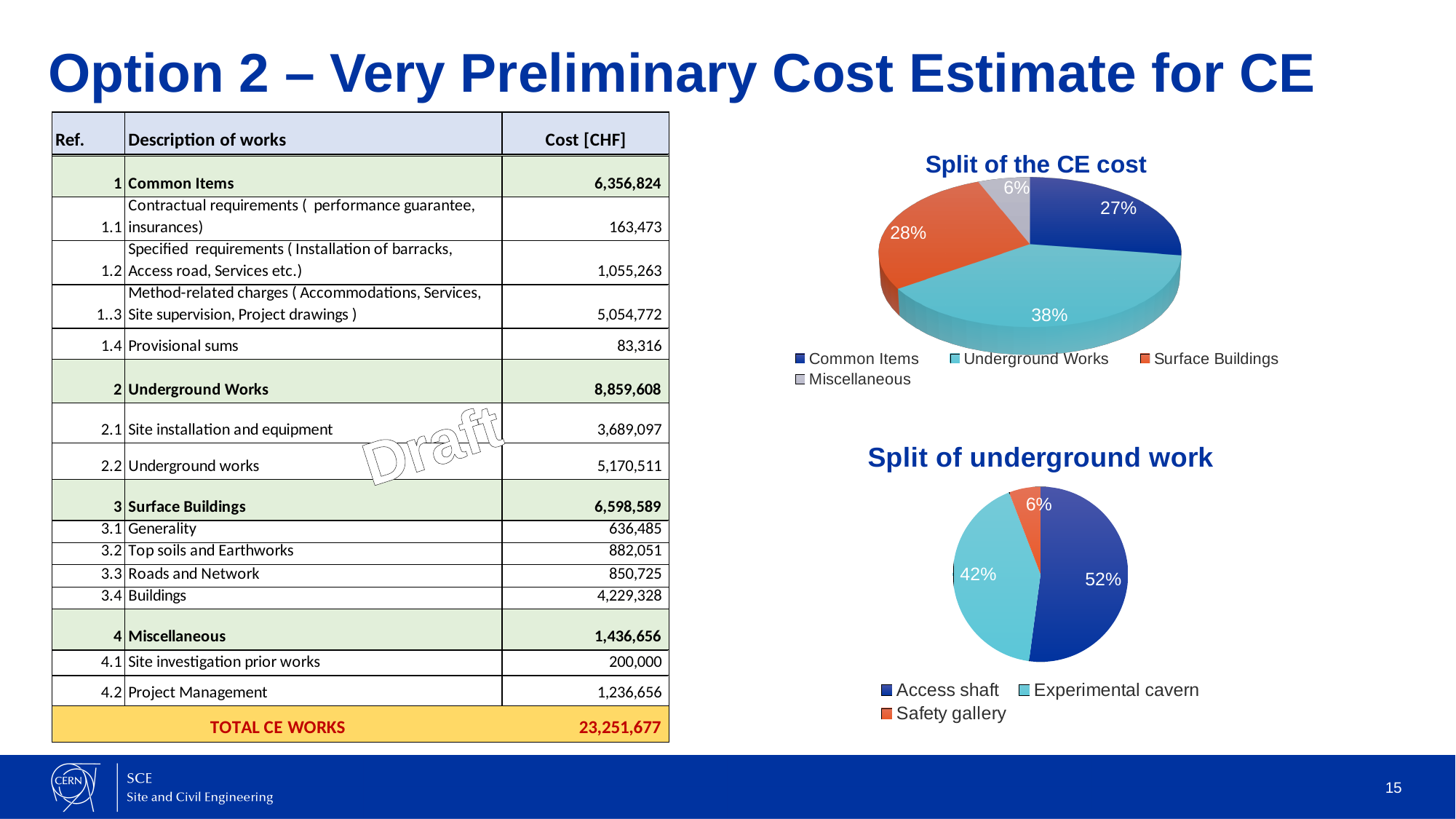
In the 'Split of underground work' chart, which is larger: Access shaft or Experimental cavern? Access shaft In the 'Split of underground work' chart, what share does Experimental cavern have? 42% In the 'Split of the CE cost' chart, what is the difference in percentage points between Underground Works and Surface Buildings? 10 In the 'Split of underground work' chart, what share does Access shaft have? 52% In the 'Split of underground work' chart, which category has the smallest share? Safety gallery In the 'Split of underground work' chart, how many slices are there? 3 In the 'Split of the CE cost' chart, what share does Underground Works have? 38% What type of chart is 'Split of the CE cost'? Pie chart In the 'Split of the CE cost' chart, which category has the smallest share? Miscellaneous In the 'Split of the CE cost' chart, how many categories does the legend list? 4 In the 'Split of the CE cost' chart, what share does Common Items have? 27% In the 'Split of the CE cost' chart, which category has the largest share? Underground Works